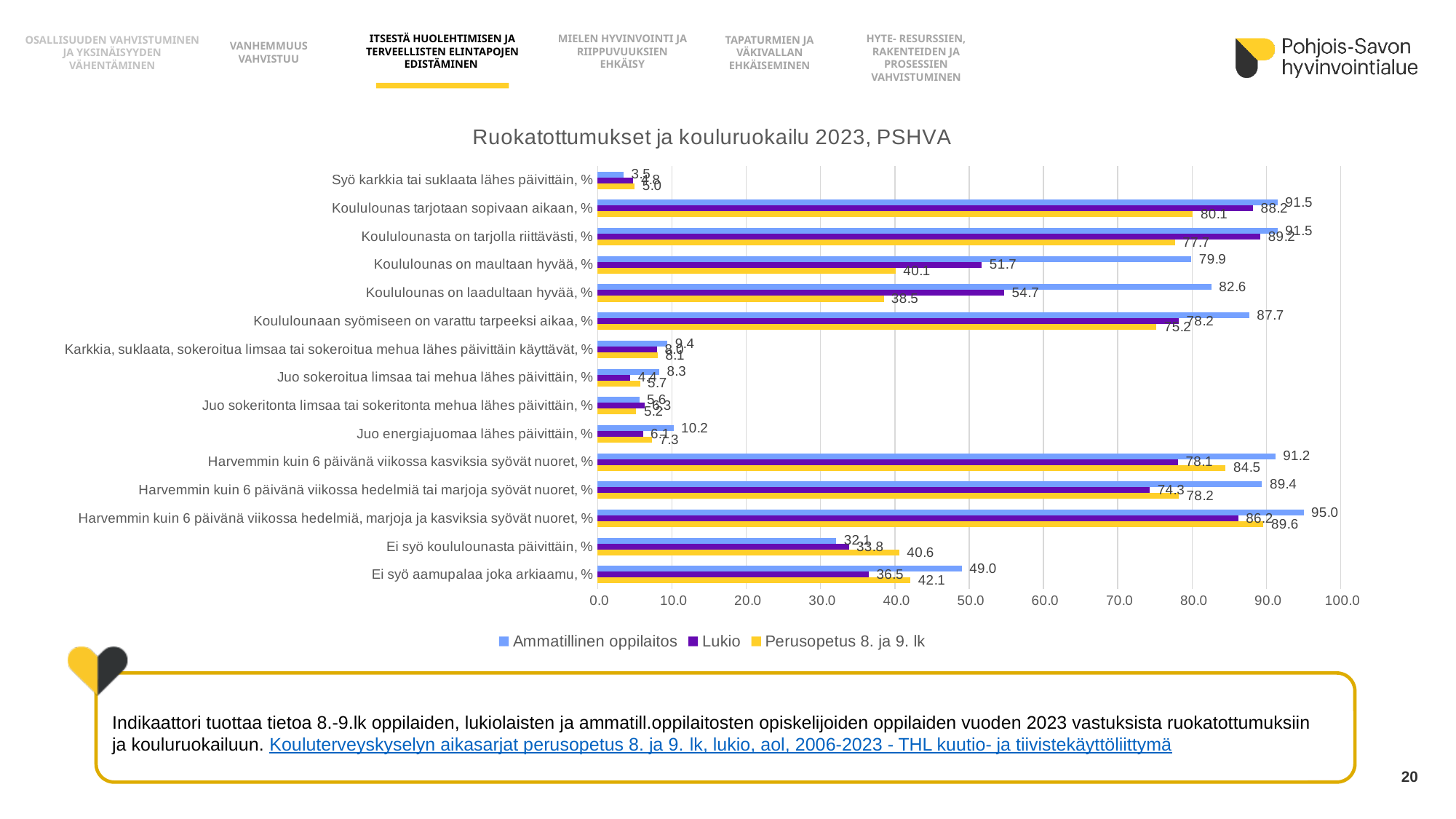
What kind of chart is shown on the slide? Bar chart In the category "Ei syö aamupalaa joka arkiaamu, %", which is larger: the Lukio value or the Perusopetus 8. ja 9. lk value? Perusopetus 8. ja 9. lk How many categories are shown on the chart? 15 Which category has the highest value for Ammatillinen oppilaitos? Harvemmin kuin 6 päivänä viikossa hedelmiä, marjoja ja kasviksia syövät nuoret, % What is the value for Ammatillinen oppilaitos in the category "Koululounas on maultaan hyvää, %"? 79.9 Is the Lukio value for "Koululounas on maultaan hyvää, %" greater or less than 50.0? greater What is the value for Perusopetus 8. ja 9. lk in the category "Ei syö koululounasta päivittäin, %"? 40.6 What is the difference between the Ammatillinen oppilaitos and Perusopetus 8. ja 9. lk values for "Koululounas on laadultaan hyvää, %"? 44.1 How many series does the legend list? 3 What is the value for Lukio in the category "Koululounas on laadultaan hyvää, %"? 54.7 What is the title of the chart? Ruokatottumukset ja kouluruokailu 2023, PSHVA Which category has the lowest value for Perusopetus 8. ja 9. lk? Syö karkkia tai suklaata lähes päivittäin, %